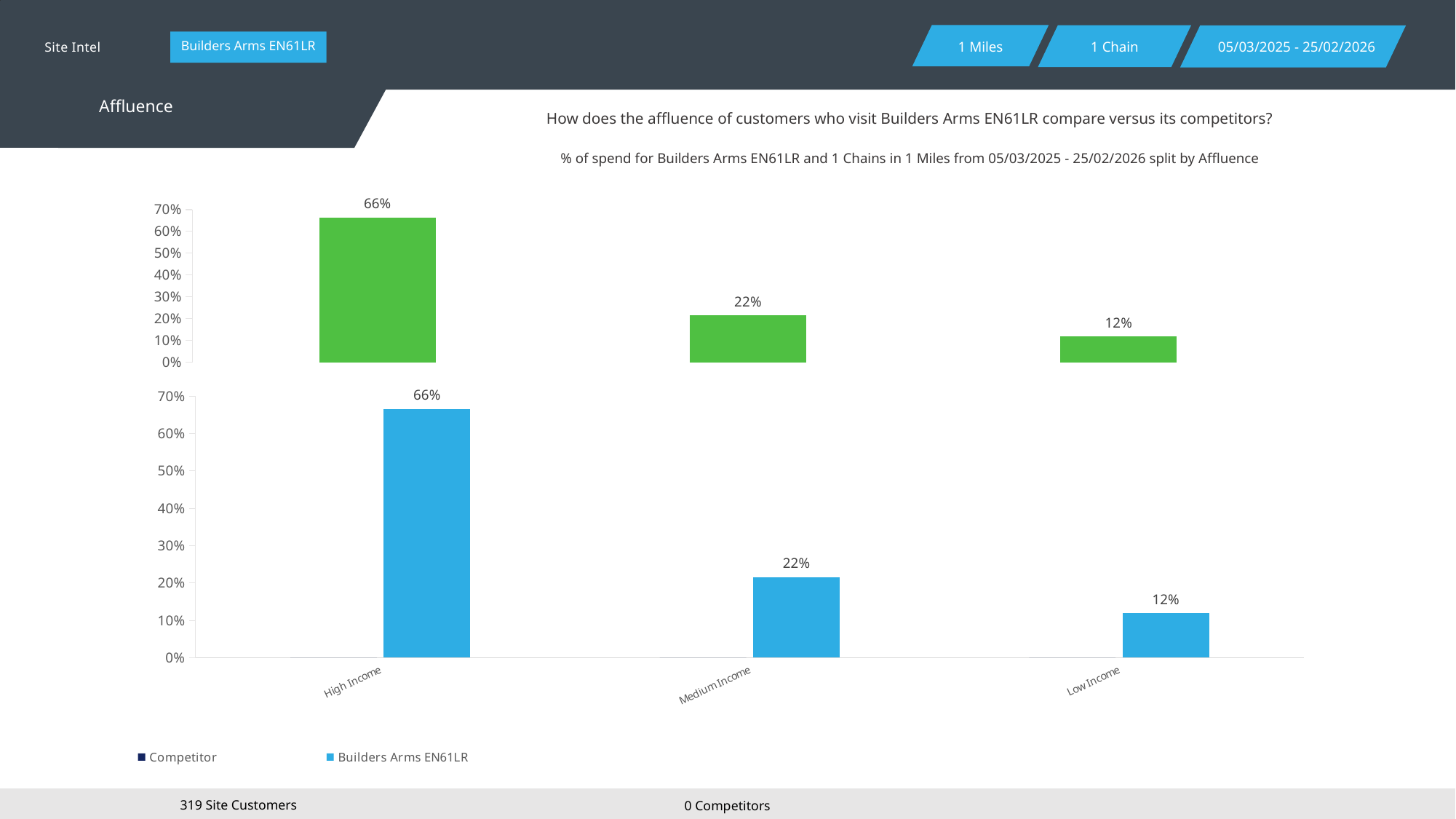
In the bottom chart, what is the value for Low Income? 12% How many series does the legend below the charts list? 2 In the bottom chart, which category has the highest value? High Income In the bottom chart, which is larger, the value for Medium Income or the value for Low Income? Medium Income In the bottom chart, what is the value for Medium Income? 22% What kind of chart is the bottom chart? Bar chart In the bottom chart, what is the value for High Income? 66% How many categories are shown on the x axis of the bottom chart? 3 In the bottom chart, which category has the lowest value? Low Income In the bottom chart, do the values rise or fall from High Income to Low Income? Fall In the bottom chart, what is the difference between the High Income and Medium Income values? 44% In the bottom chart, what is the difference between the Medium Income and Low Income values? 10%